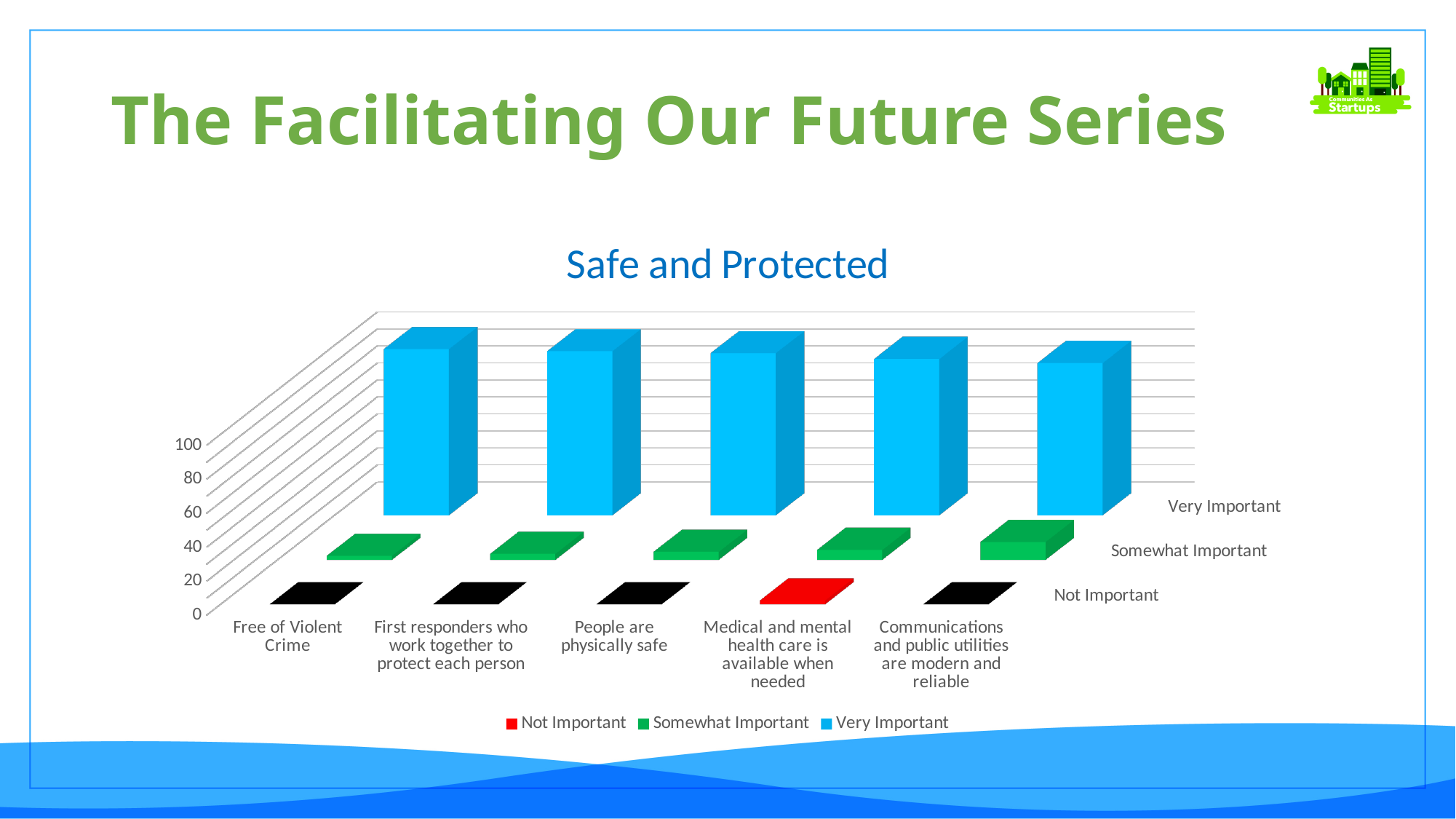
Is the Not Important value for Medical and mental health care is available when needed greater or less than 20? less Which category has the highest Very Important value? Free of Violent Crime How many series does the legend list? 3 Which series is shown in red in the legend? Not Important Which category has the lowest Very Important value? Communications and public utilities are modern and reliable What kind of chart is shown on the slide? bar chart Do the Very Important values rise or fall from left to right across the categories? fall How many categories are shown along the x axis? 5 Is the Somewhat Important value for People are physically safe greater or less than 20? less Is the Very Important value for Free of Violent Crime greater or less than 40? greater What is the title of the chart? Safe and Protected For Communications and public utilities are modern and reliable, which is larger: Very Important or Somewhat Important? Very Important